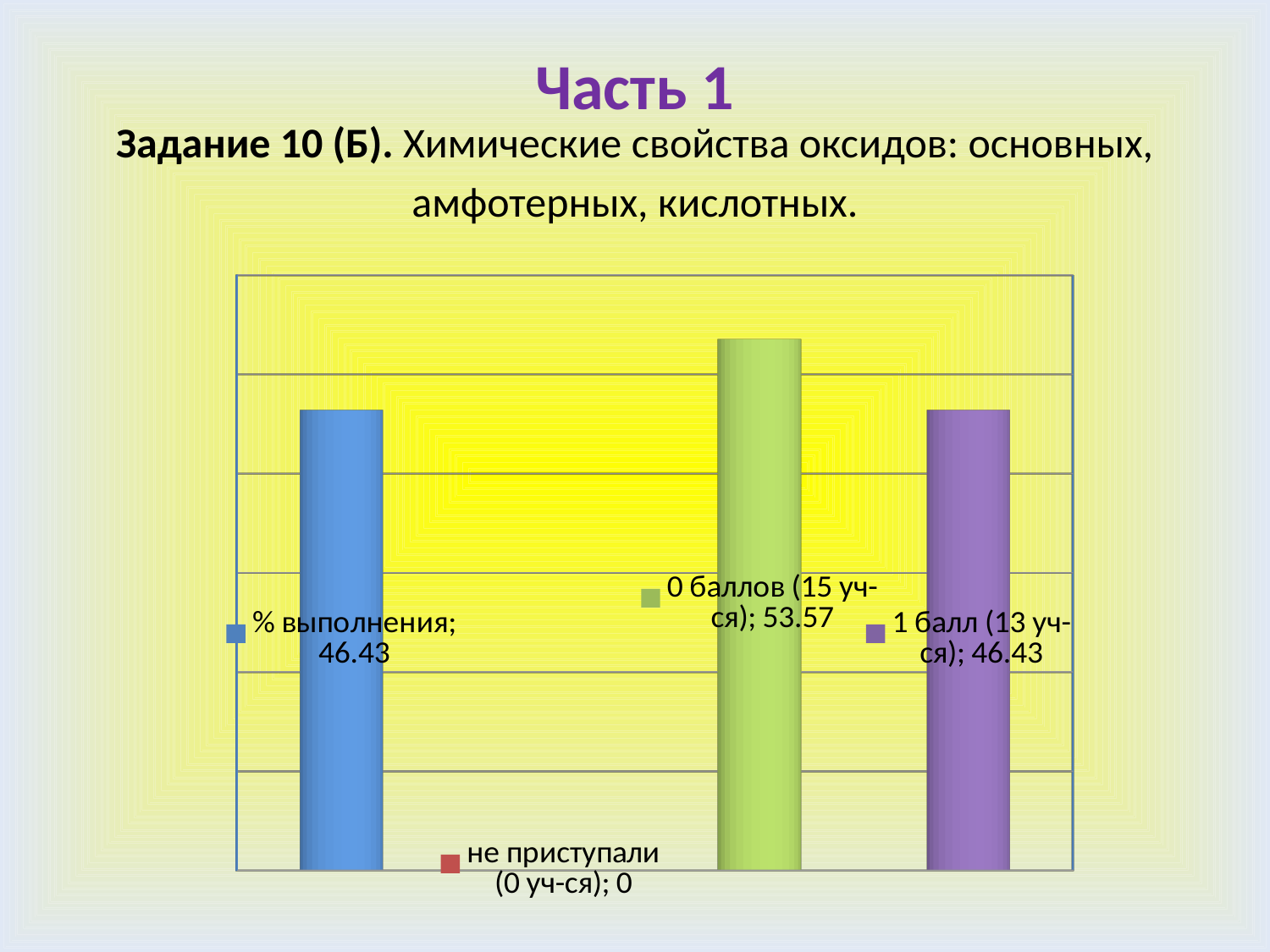
What is the value shown for "не приступали (0 уч-ся)"? 0 What kind of chart is shown on the slide? bar chart What is the value shown for "1 балл (13 уч-ся)"? 46.43 What colour is the bar for "0 баллов (15 уч-ся)"? green How many data labels are shown on the chart? 4 Which is larger: the value for "0 баллов (15 уч-ся)" or the value for "% выполнения"? 0 баллов (15 уч-ся) What is the value shown for "% выполнения"? 46.43 Which category has the highest value? 0 баллов (15 уч-ся) What is the title at the top of the slide? Часть 1 Which category has the lowest value? не приступали (0 уч-ся) What is the difference between the values for "0 баллов (15 уч-ся)" and "1 балл (13 уч-ся)"? 7.14 What is the value shown for "0 баллов (15 уч-ся)"? 53.57